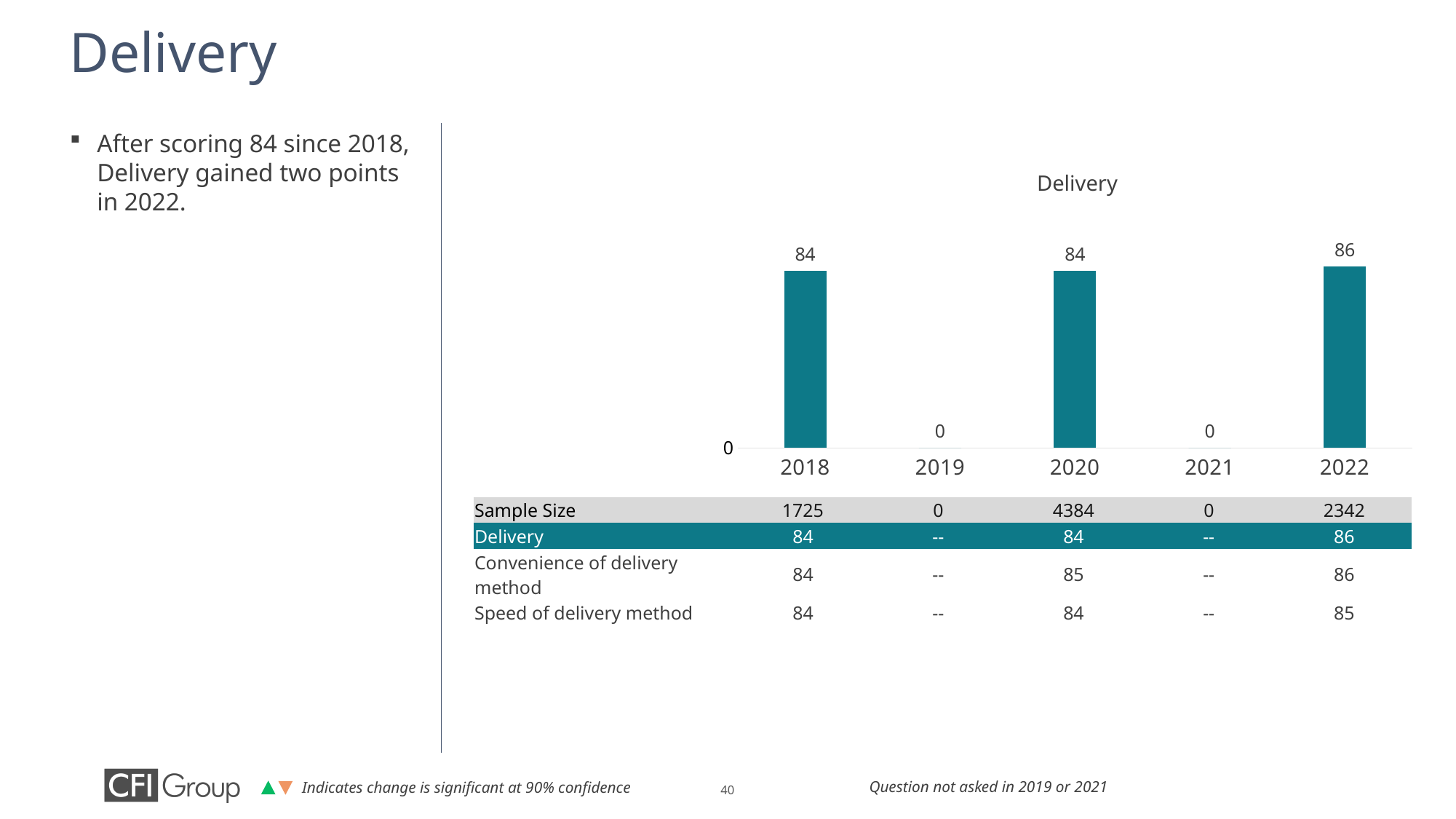
How many years in the chart have a value of 0? 2 What is the Delivery score for 2022? 86 What is the Delivery score for 2020? 84 Which year has the highest Delivery score? 2022 What is the Delivery score for 2018? 84 Does the Delivery score rise or fall from 2020 to 2022? Rise How many years are shown on the x axis of the chart? 5 What value is shown for 2019 in the chart? 0 What kind of chart is shown on the slide? Bar chart What is the title of the chart? Delivery What is the difference between the Delivery scores for 2022 and 2020? 2 Is the Delivery score for 2022 larger than the score for 2018? Yes